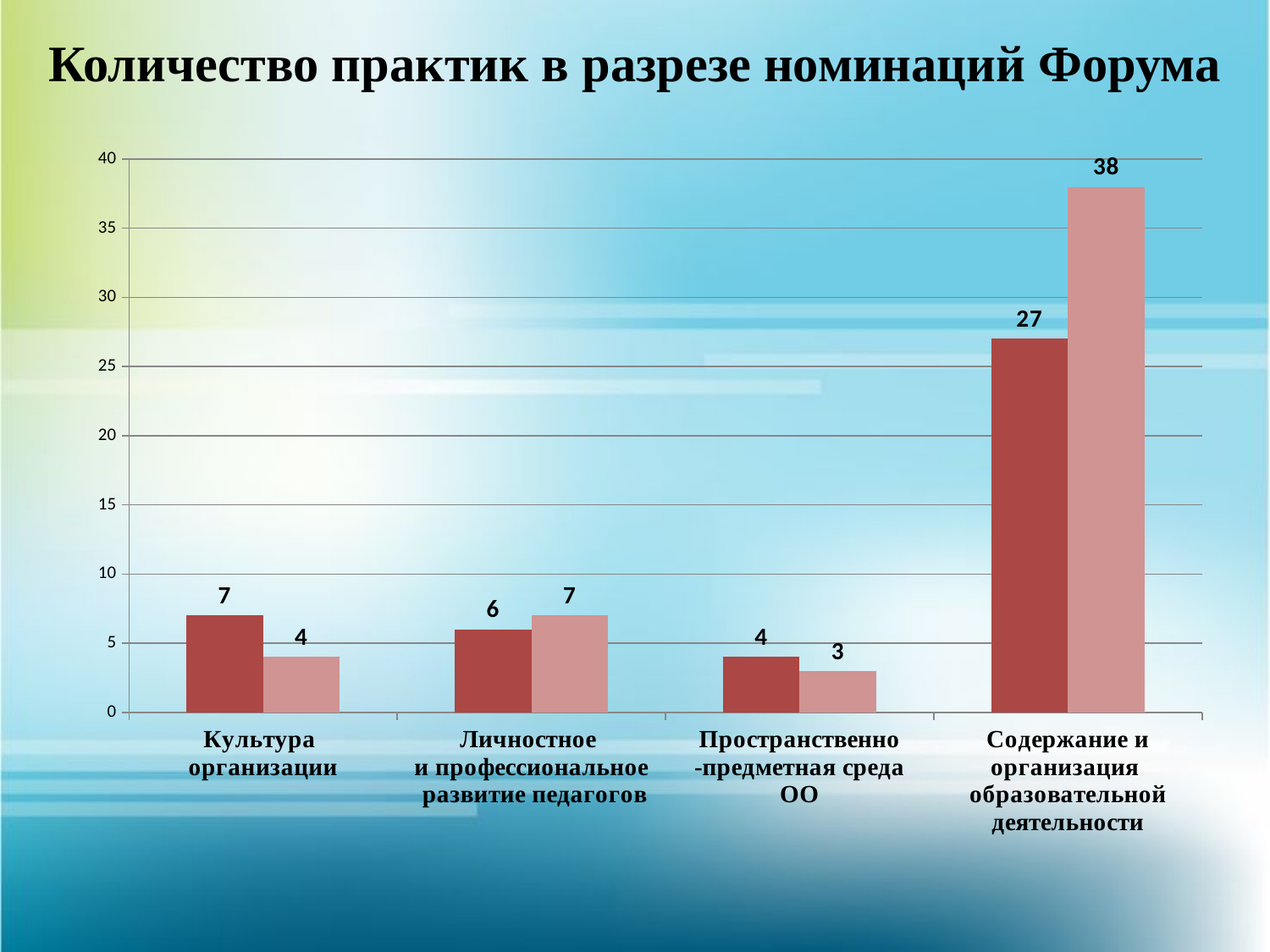
How many categories are shown on the x axis? 4 What is the title of the slide? Количество практик в разрезе номинаций Форума What is the difference between the light pink and dark red bars for Содержание и организация образовательной деятельности? 11 What is the value of the dark red bar for Культура организации? 7 Is the dark red bar for Содержание и организация образовательной деятельности greater or less than 25? greater What kind of chart is shown on the slide? bar chart What is the value of the light pink bar for Содержание и организация образовательной деятельности? 38 What is the value of the dark red bar for Пространственно-предметная среда ОО? 4 Which category has the highest value among the dark red bars? Содержание и организация образовательной деятельности Which category has the lowest value among the light pink bars? Пространственно-предметная среда ОО What is the value of the light pink bar for Личностное и профессиональное развитие педагогов? 7 Which is larger for Культура организации: the dark red bar or the light pink bar? the dark red bar